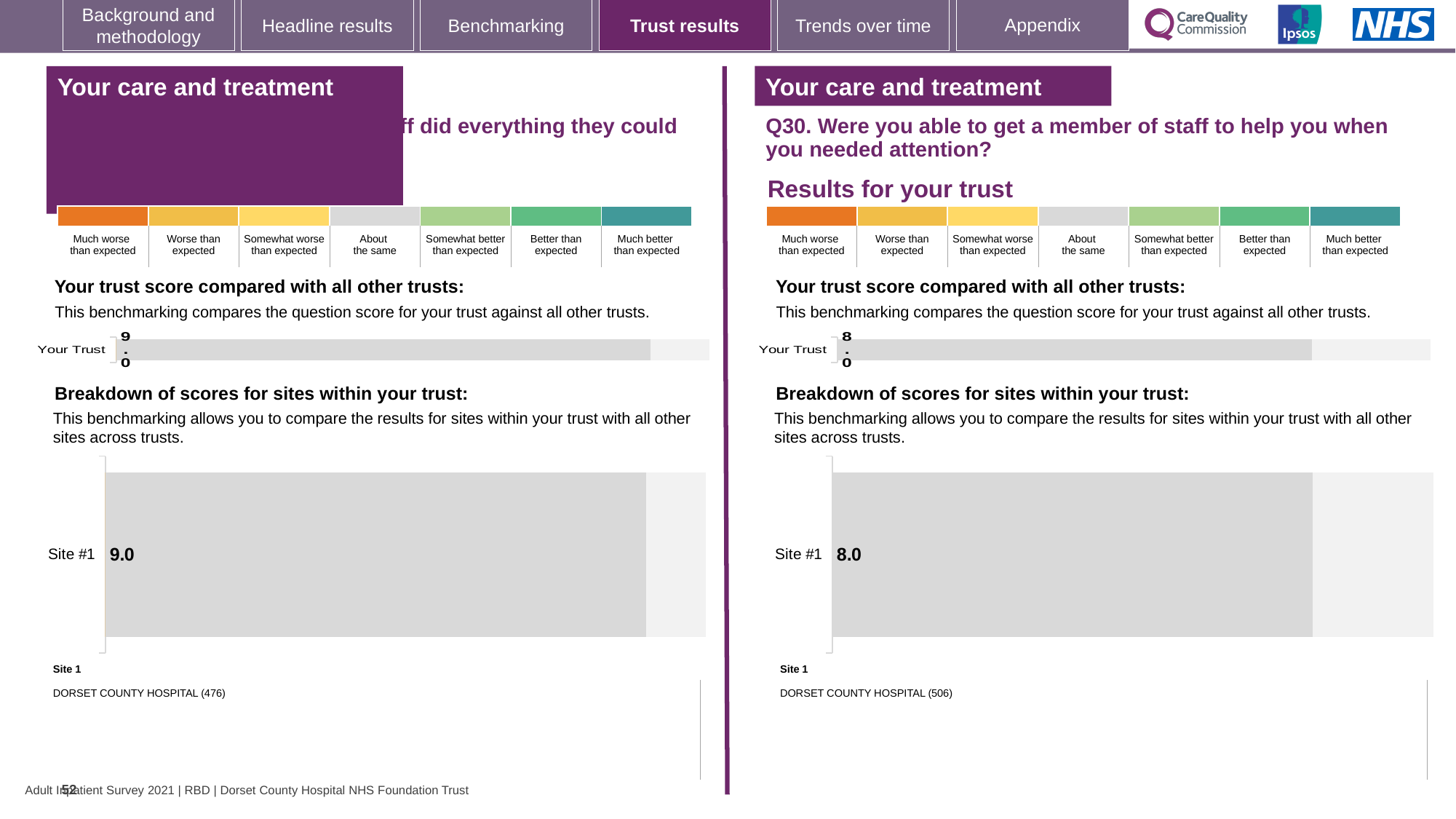
Which is larger: the Site #1 score on the left-hand chart or the Site #1 score on the right-hand chart for Q30? Left-hand chart (9.0) On the left-hand chart, what is the score shown for Your Trust? 9.0 On the right-hand chart for Q30, what is the score shown for Site #1? 8.0 On the left-hand side, which hospital is listed as Site 1? DORSET COUNTY HOSPITAL (476) On the right-hand chart for Q30, what is the score shown for Your Trust? 8.0 On the right-hand side for Q30, which hospital is listed as Site 1? DORSET COUNTY HOSPITAL (506) How many sites are shown in the breakdown of scores on the right-hand chart for Q30? 1 On the left-hand chart, what is the score shown for Site #1? 9.0 What kind of chart is used to show the Site #1 score on the right-hand side for Q30? Bar chart What is the difference between the Site #1 score on the left-hand chart and the Site #1 score on the right-hand chart for Q30? 1.0 How many sites are shown in the breakdown of scores on the left-hand chart? 1